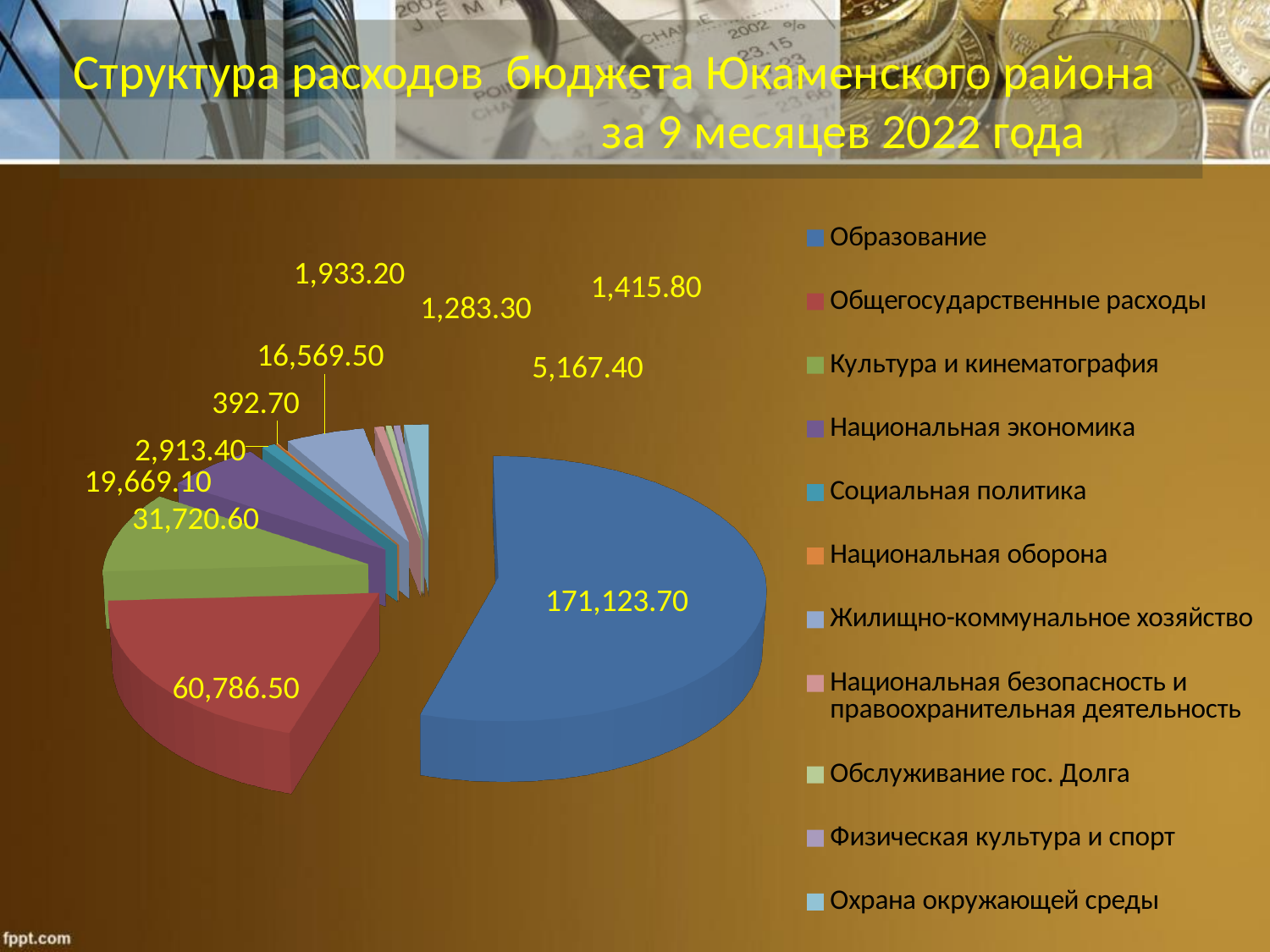
What is the difference between the values for Культура и кинематография and Национальная экономика? 12,051.50 Which category has the smallest value on the chart? Национальная оборона What is the value shown for Общегосударственные расходы? 60,786.50 What is the value shown for Национальная экономика? 19,669.10 How many categories does the legend list? 11 What type of chart is shown on the slide? Pie chart Which category has the largest slice of the pie? Образование What is the value shown for Культура и кинематография? 31,720.60 What is the value shown for Образование on the pie chart? 171,123.70 What is the value shown for Жилищно-коммунальное хозяйство? 16,569.50 What is the difference between the values for Образование and Общегосударственные расходы? 110,337.20 Which is larger: Общегосударственные расходы or Культура и кинематография? Общегосударственные расходы